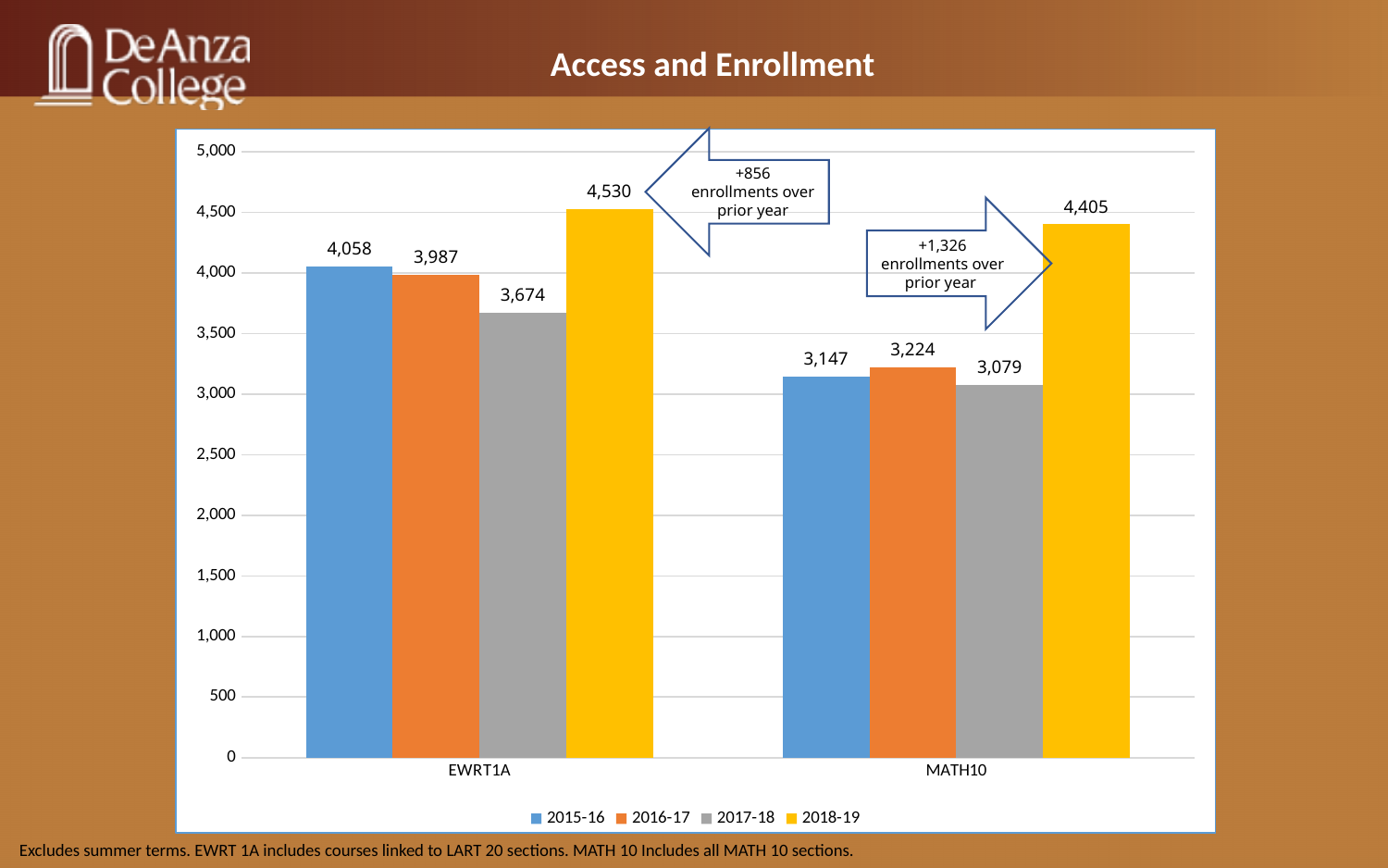
Which series has the lowest value for MATH10? 2017-18 What is the value for EWRT1A in 2018-19? 4,530 What colour are the 2018-19 bars? yellow What is the value for MATH10 in 2016-17? 3,224 What is the difference between the 2018-19 and 2017-18 values for MATH10? 1,326 Which is larger, the 2015-16 value for MATH10 or the 2016-17 value for MATH10? 2016-17 How many series does the legend list? 4 How many categories are shown on the x axis? 2 What kind of chart is shown on the slide? bar chart What is the difference between the 2015-16 values for EWRT1A and MATH10? 911 What is the value for MATH10 in 2017-18? 3,079 Which series has the highest value for EWRT1A? 2018-19